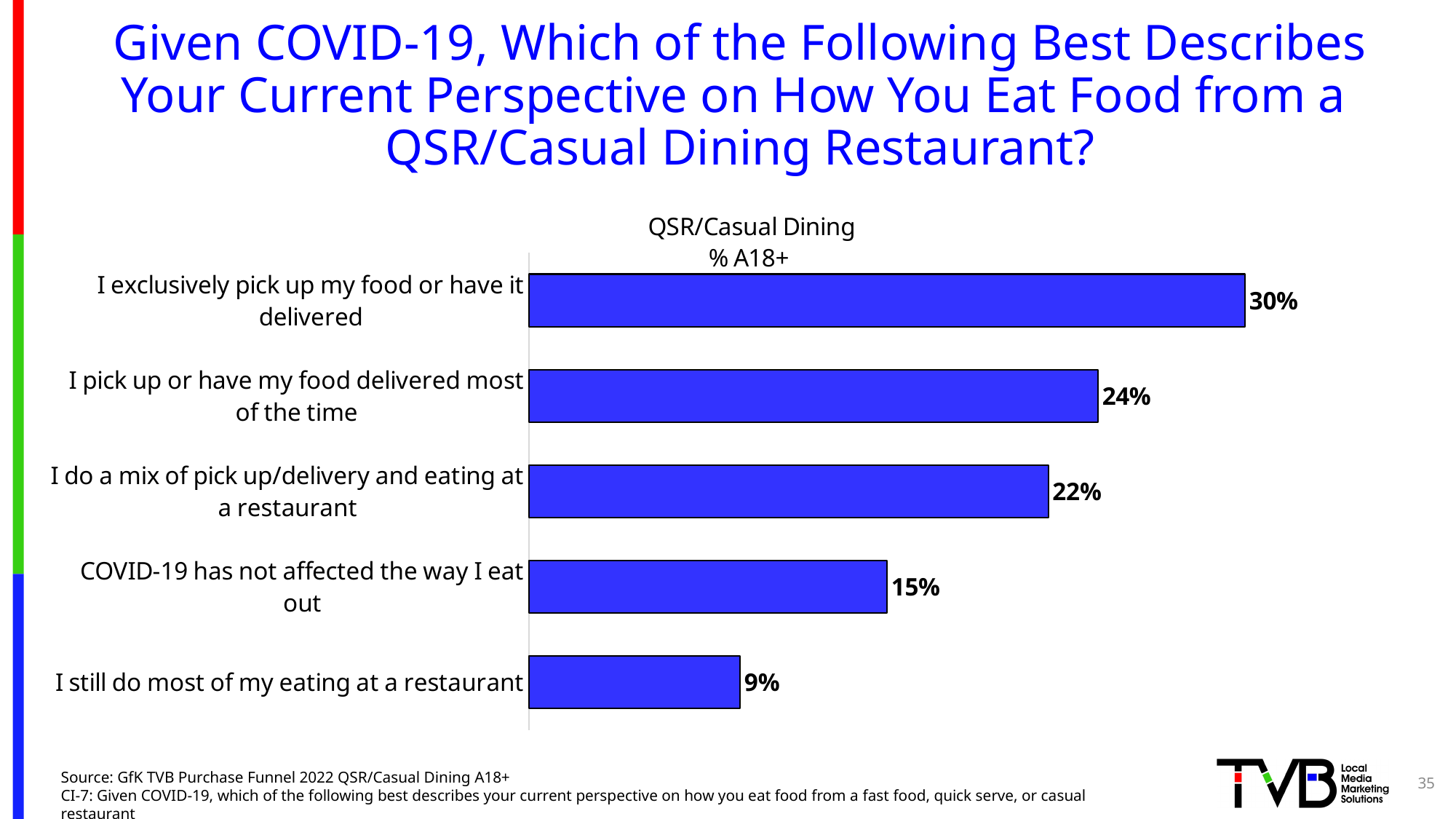
Which is larger: "I do a mix of pick up/delivery and eating at a restaurant" or "COVID-19 has not affected the way I eat out"? I do a mix of pick up/delivery and eating at a restaurant What is the difference between "I pick up or have my food delivered most of the time" and "I do a mix of pick up/delivery and eating at a restaurant"? 2% How many categories are shown in the chart? 5 What is the title of the chart? QSR/Casual Dining % A18+ Which category has the lowest value? I still do most of my eating at a restaurant Which category has the highest value? I exclusively pick up my food or have it delivered What percentage of respondents say they exclusively pick up their food or have it delivered? 30% What percentage say COVID-19 has not affected the way they eat out? 15% What is the value for "I still do most of my eating at a restaurant"? 9% What is the difference between "I exclusively pick up my food or have it delivered" and "I still do most of my eating at a restaurant"? 21% What is the value for "I pick up or have my food delivered most of the time"? 24% What kind of chart is shown on the slide? Bar chart